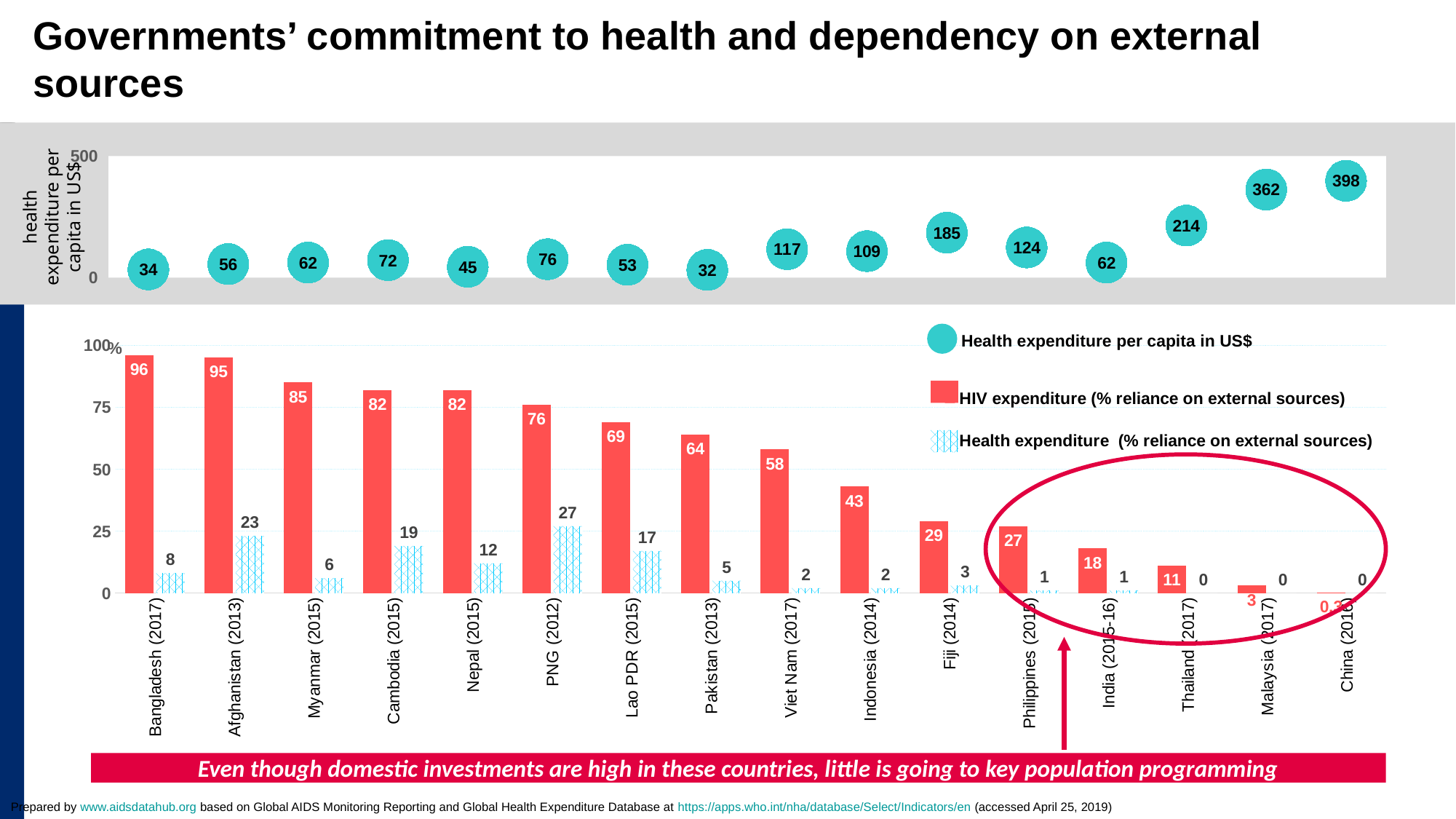
Which country has the highest health expenditure per capita in US$? China (2016) Which country has the lowest health expenditure per capita in US$? Pakistan (2013) How many countries are shown on the chart? 16 What is the health expenditure (% reliance on external sources) for PNG (2012)? 27 Do the HIV expenditure (% reliance on external sources) bars rise or fall from left to right across the countries? fall What is the difference between the HIV expenditure (% reliance on external sources) for Afghanistan (2013) and its health expenditure (% reliance on external sources)? 72 Which country has the highest health expenditure (% reliance on external sources)? PNG (2012) What is the HIV expenditure (% reliance on external sources) for Bangladesh (2017)? 96 Which is larger: the health expenditure per capita in US$ for Viet Nam (2017) or for Indonesia (2014)? Viet Nam (2017) Is the HIV expenditure (% reliance on external sources) for Lao PDR (2015) greater or less than 50? greater How many series does the legend list? 3 What is the health expenditure per capita in US$ for China (2016)? 398